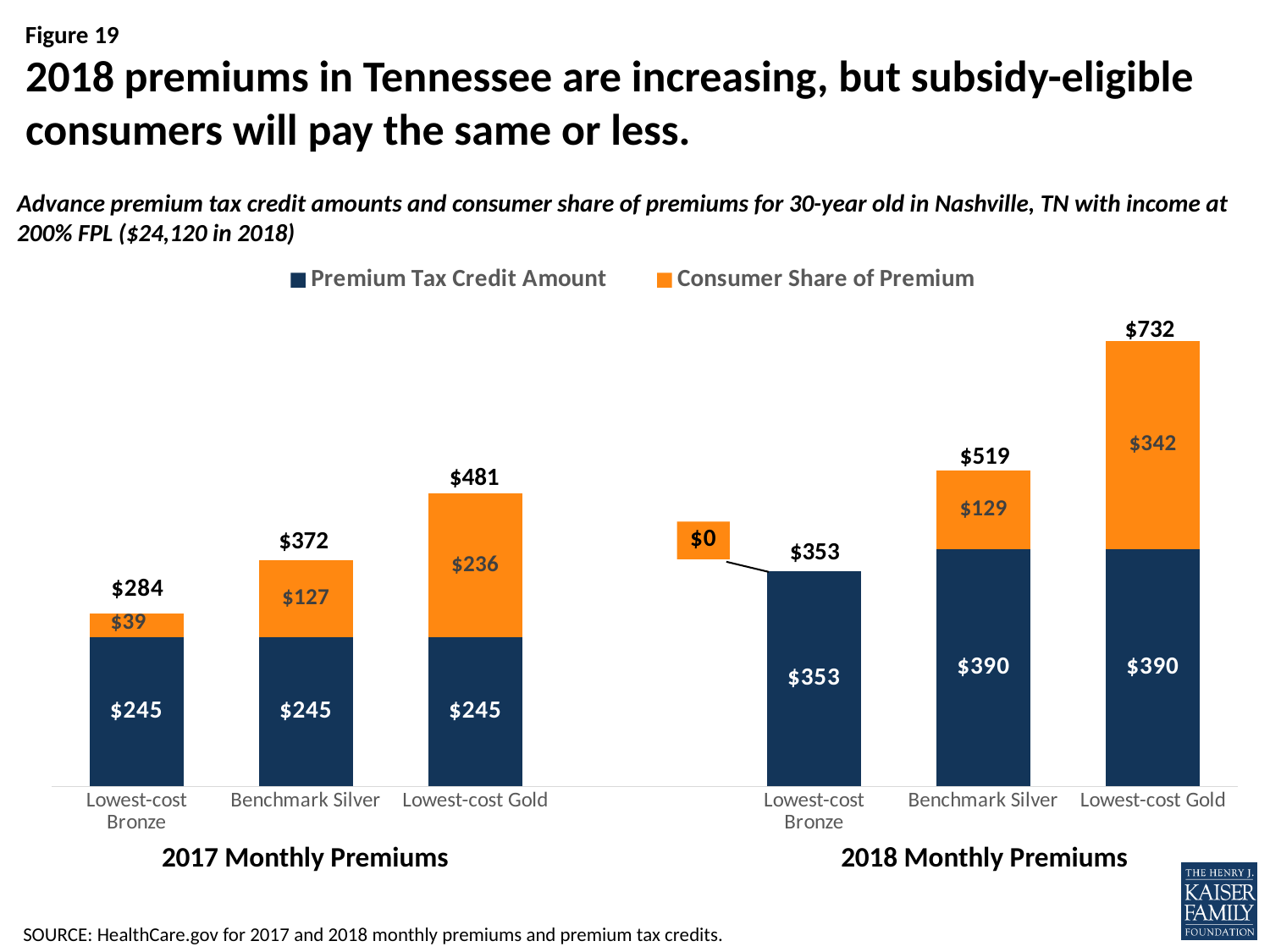
What is the Consumer Share of Premium for Lowest-cost Gold under 2018 Monthly Premiums? $342 Which colour represents the Consumer Share of Premium in the chart? Orange How many series does the legend list? 2 Which plan has the lowest total monthly premium across both years? Lowest-cost Bronze (2017) Which is larger: the Consumer Share of Premium for Benchmark Silver in 2017 or in 2018? 2018 What is the Consumer Share of Premium for Lowest-cost Bronze under 2018 Monthly Premiums? $0 What is the Premium Tax Credit Amount for Benchmark Silver under 2017 Monthly Premiums? $245 What is the total monthly premium for Lowest-cost Bronze in 2017? $284 Which plan has the highest total monthly premium across both years? Lowest-cost Gold (2018) What is the difference between the Premium Tax Credit Amount for Lowest-cost Gold in 2018 and in 2017? $145 What kind of chart is shown on the slide? Stacked bar chart What is the total monthly premium for Benchmark Silver in 2018? $519